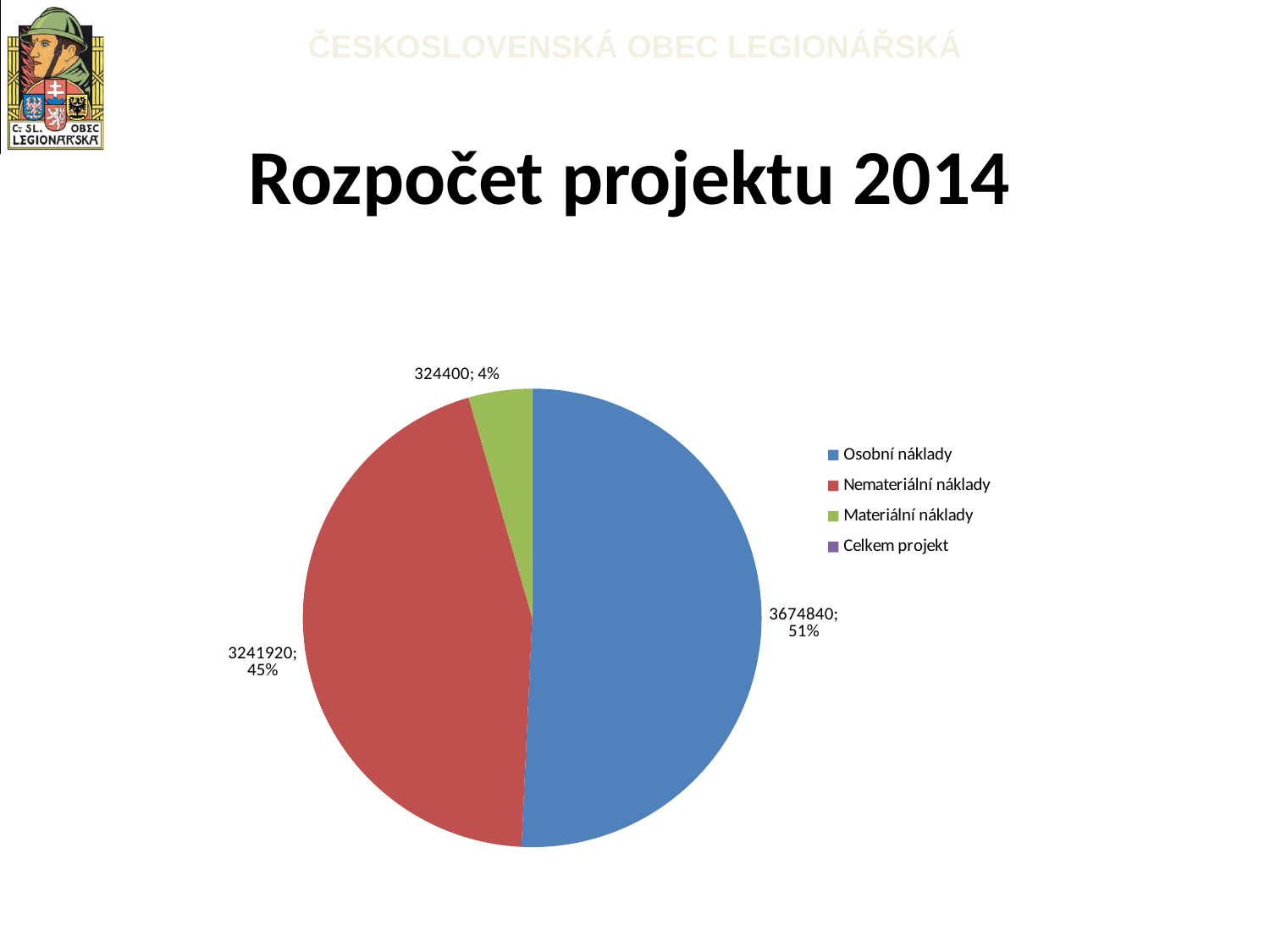
What share of the pie does Osobní náklady represent? 51% What share of the pie does Nemateriální náklady represent? 45% What is the value for Osobní náklady? 3674840 What type of chart is shown on the slide? pie chart What colour is the slice for Nemateriální náklady? red How many entries does the legend list? 4 Which category has the smallest visible slice of the pie? Materiální náklady What is the difference between the values for Osobní náklady and Nemateriální náklady? 432920 Which category has the largest slice of the pie? Osobní náklady What share of the pie does Materiální náklady represent? 4% What is the value for Nemateriální náklady? 3241920 What is the value for Materiální náklady? 324400